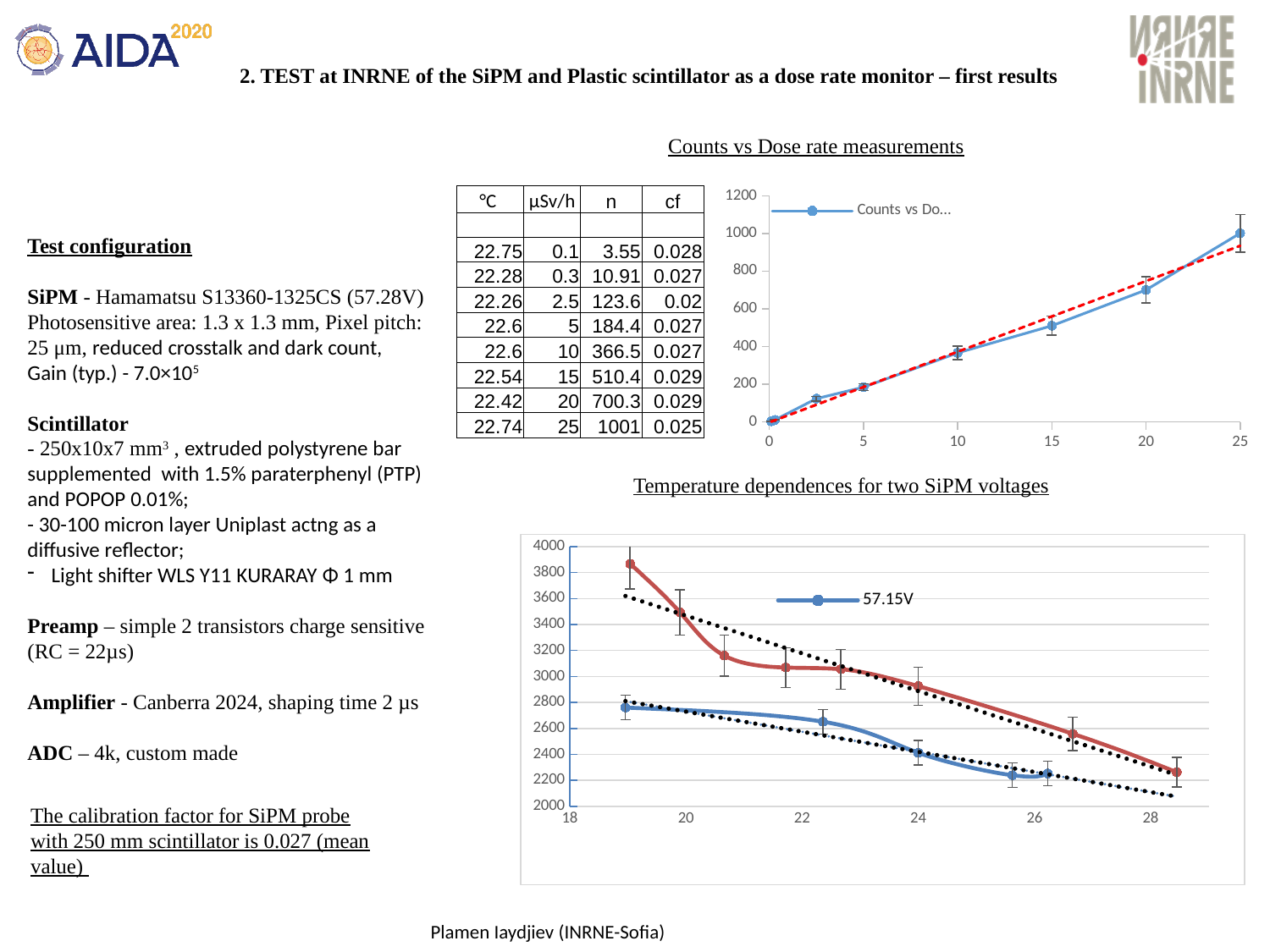
What kind of chart is the 'Temperature dependences for two SiPM voltages' chart? line chart In the 'Temperature dependences for two SiPM voltages' chart, is the first (leftmost) point of the blue series greater or less than 3000? less In the 'Counts vs Dose rate measurements' chart, do the counts rise or fall as the dose rate increases along the x axis? rise In the 'Counts vs Dose rate measurements' chart, is the value at x = 10 greater or less than 400? less In the 'Counts vs Dose rate measurements' chart, at which x-axis value is the plotted count highest? 25 According to the table next to the 'Counts vs Dose rate measurements' chart, what is the count n at 25 µSv/h? 1001 What kind of chart is the 'Counts vs Dose rate measurements' chart? line chart In the 'Temperature dependences for two SiPM voltages' chart, which series has the higher values, the red one or the blue one? the red one In the 'Temperature dependences for two SiPM voltages' chart, do the plotted values rise or fall as temperature increases along the x axis? fall In the 'Counts vs Dose rate measurements' chart, is the value at x = 20 greater or less than 600? greater What is the only legend entry shown in the 'Temperature dependences for two SiPM voltages' chart? 57.15V